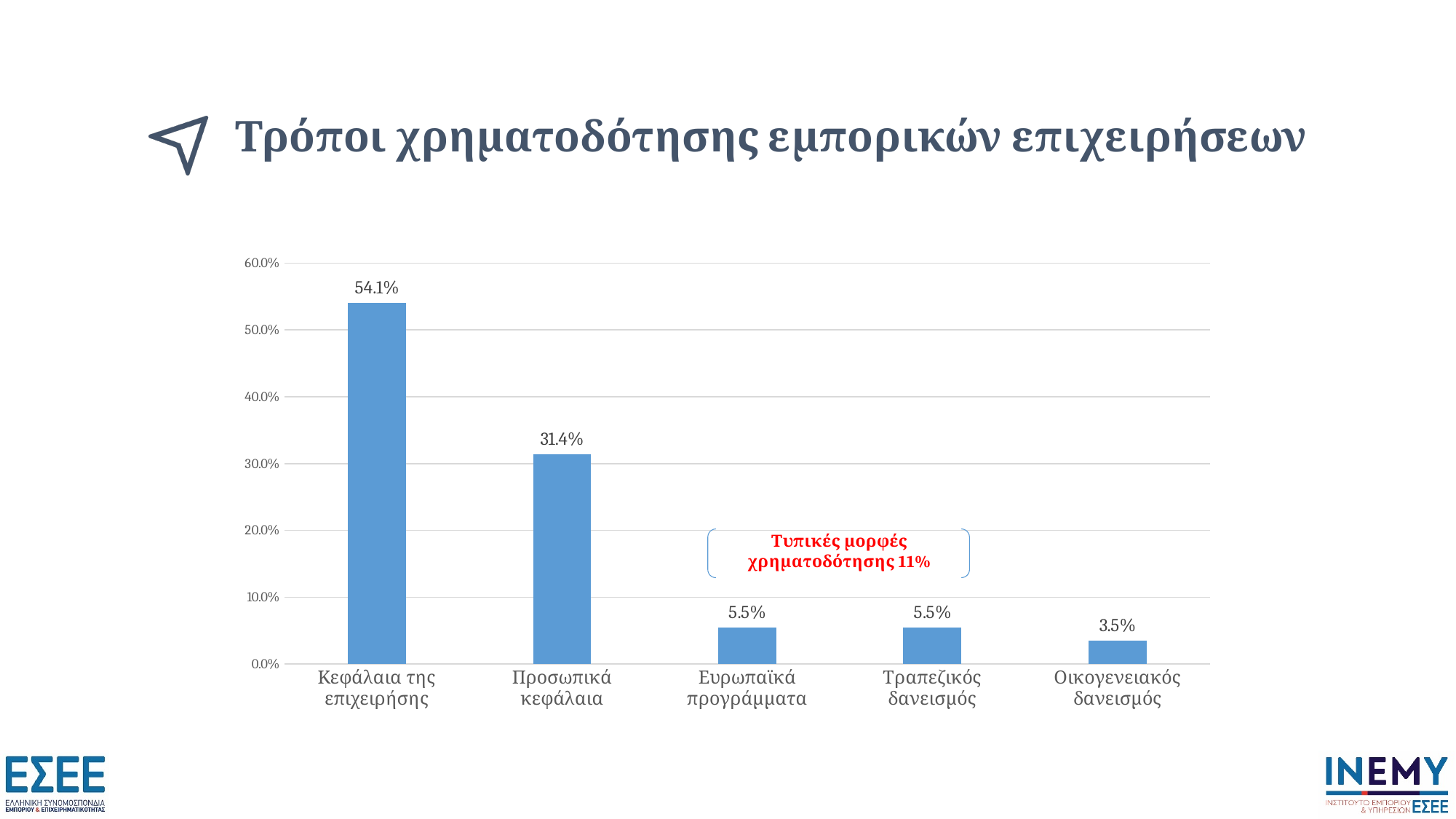
What is the value for Κεφάλαια της επιχείρησης? 54.1% What kind of chart is shown on the slide? bar chart Which is larger, the value for Προσωπικά κεφάλαια or the value for Ευρωπαϊκά προγράμματα? Προσωπικά κεφάλαια What is the value for Οικογενειακός δανεισμός? 3.5% How many categories are shown on the x axis? 5 What is the title of the slide? Τρόποι χρηματοδότησης εμπορικών επιχειρήσεων Which category has the highest value? Κεφάλαια της επιχείρησης Is the value for Προσωπικά κεφάλαια greater or less than 30.0%? greater What is the difference between the values for Κεφάλαια της επιχείρησης and Προσωπικά κεφάλαια? 22.7% What is the value for Τραπεζικός δανεισμός? 5.5% Which category has the lowest value? Οικογενειακός δανεισμός What is the value for Προσωπικά κεφάλαια? 31.4%